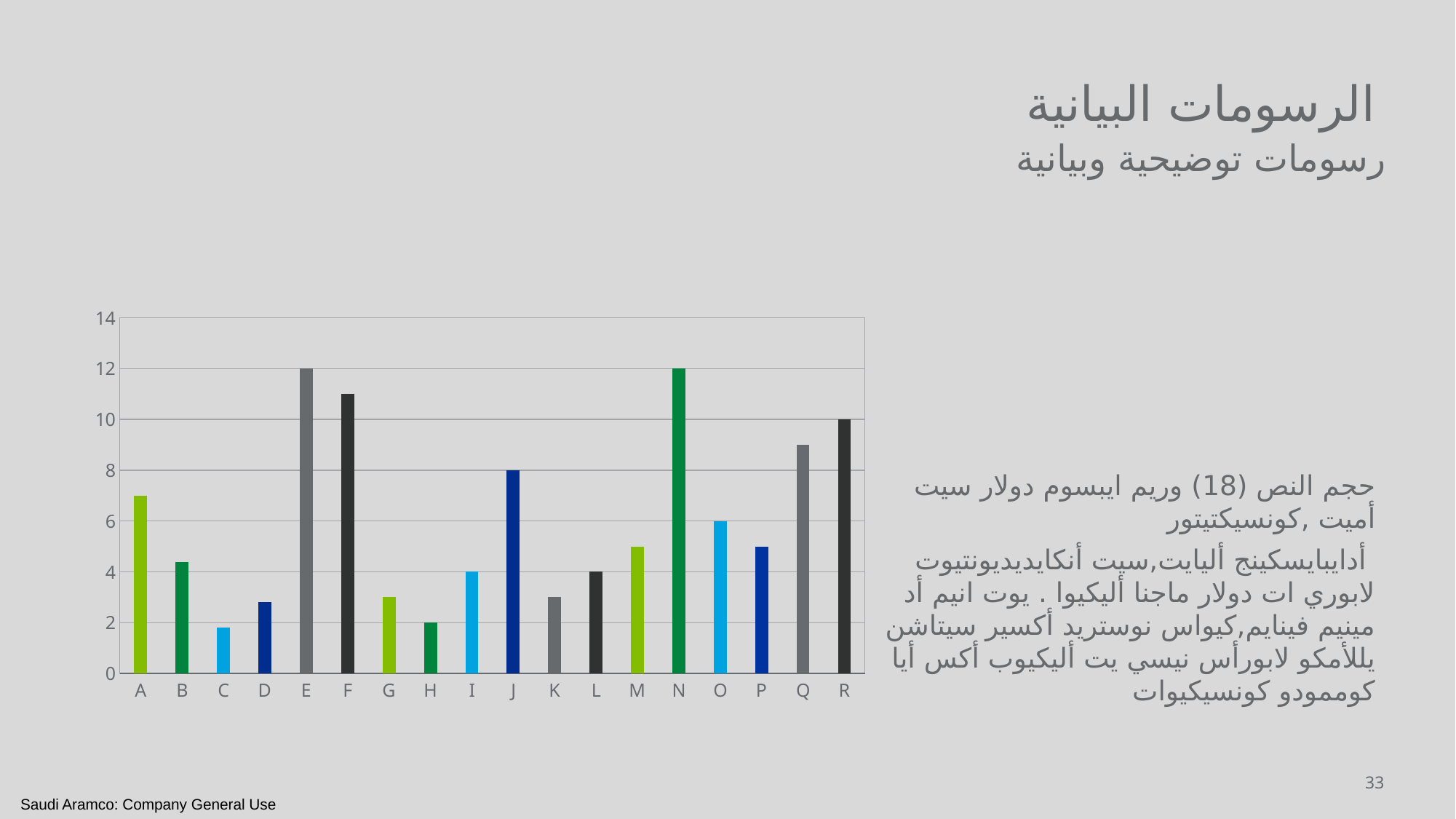
What kind of chart is shown on the slide? bar chart What is the value for category O? 6 What is the difference between the values for E and R? 2 Which has the larger value, E or F? E How many categories are plotted on the x axis of the chart? 18 Is the value for F greater or less than 10? greater What is the value for category R? 10 What is the value for category J? 8 Is the value for C greater or less than 4? less Which has the larger value, J or K? J Is the value for Q greater or less than 8? greater What is the value for category E? 12